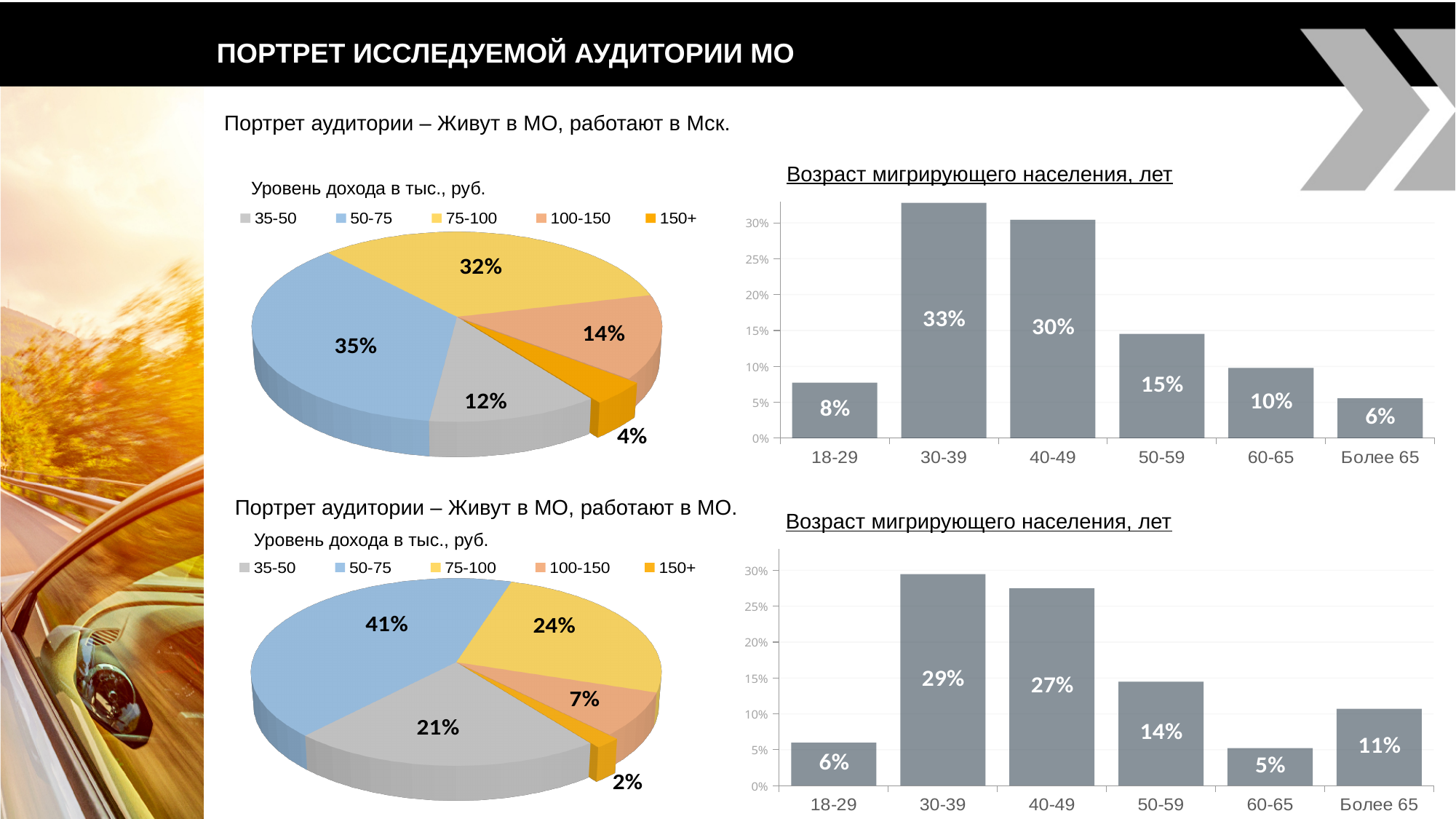
In the bottom-right bar chart (Возраст мигрирующего населения, лет), what is the value for the Более 65 age group? 11% In the bottom-right bar chart, how many age groups are shown on the x axis? 6 In the bottom-right bar chart, which is larger: the value for 18-29 or the value for 60-65? 18-29 In the top-right bar chart (Возраст мигрирующего населения, лет), which age group has the lowest value? Более 65 What type of chart is used to show the age of the migrating population on the right side of the slide? Bar chart How many income categories does the legend of the top-left pie chart list? 5 In the top-right bar chart, what is the difference between the values for the 40-49 and 50-59 age groups? 15% In the top-left pie chart (Живут в МО, работают в Мск.), which income level has the smallest share? 150+ In the top-left pie chart (Живут в МО, работают в Мск.), what share of the audience has an income level of 50-75 thousand rubles? 35% In the top-right bar chart (Возраст мигрирующего населения, лет), what is the value for the 30-39 age group? 33% In the bottom-left pie chart (Живут в МО, работают в МО.), which income level has the largest share? 50-75 In the bottom-left pie chart (Живут в МО, работают в МО.), what share of the audience has an income level of 100-150 thousand rubles? 7%